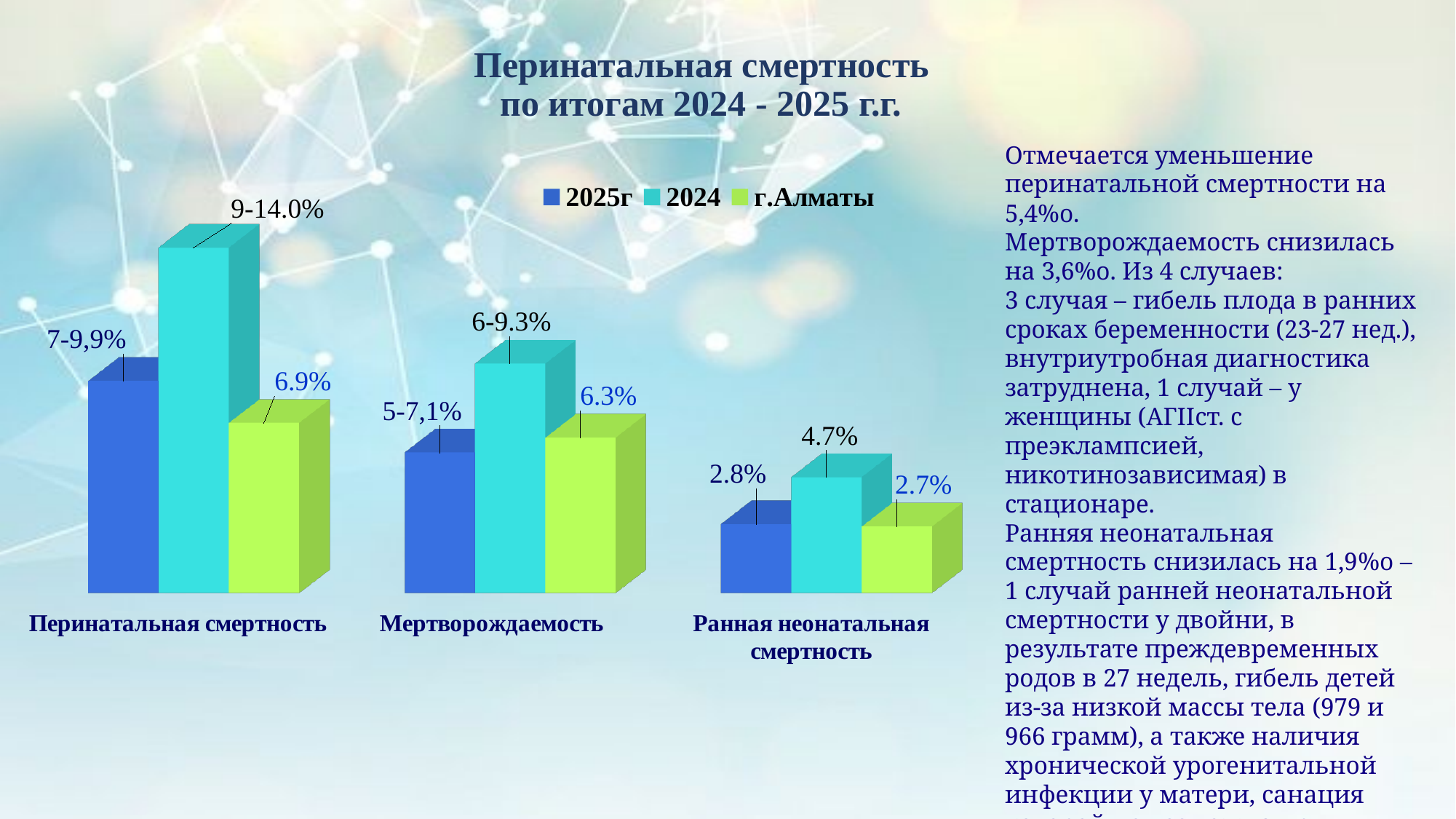
In the Ранная неонатальная смертность category, what is the difference between the 2024 value and the 2025г value? 1.9% How many categories are shown on the x axis of the chart? 3 What is the value for 2024 in the Ранная неонатальная смертность category? 4.7% Which is larger in the Перинатальная смертность category: the 2024 bar or the г.Алматы bar? 2024 What is the value for г.Алматы in the Мертворождаемость category? 6.3% How many series does the chart legend list? 3 Which series has the highest bar in the Мертворождаемость category? 2024 What kind of chart is shown on the slide? bar chart What is the data label for the 2025г series in the Перинатальная смертность category? 7-9,9% What is the value for 2025г in the Ранная неонатальная смертность category? 2.8% Which series has the lowest bar in the Ранная неонатальная смертность category? г.Алматы What is the data label for the 2024 series in the Перинатальная смертность category? 9-14.0%